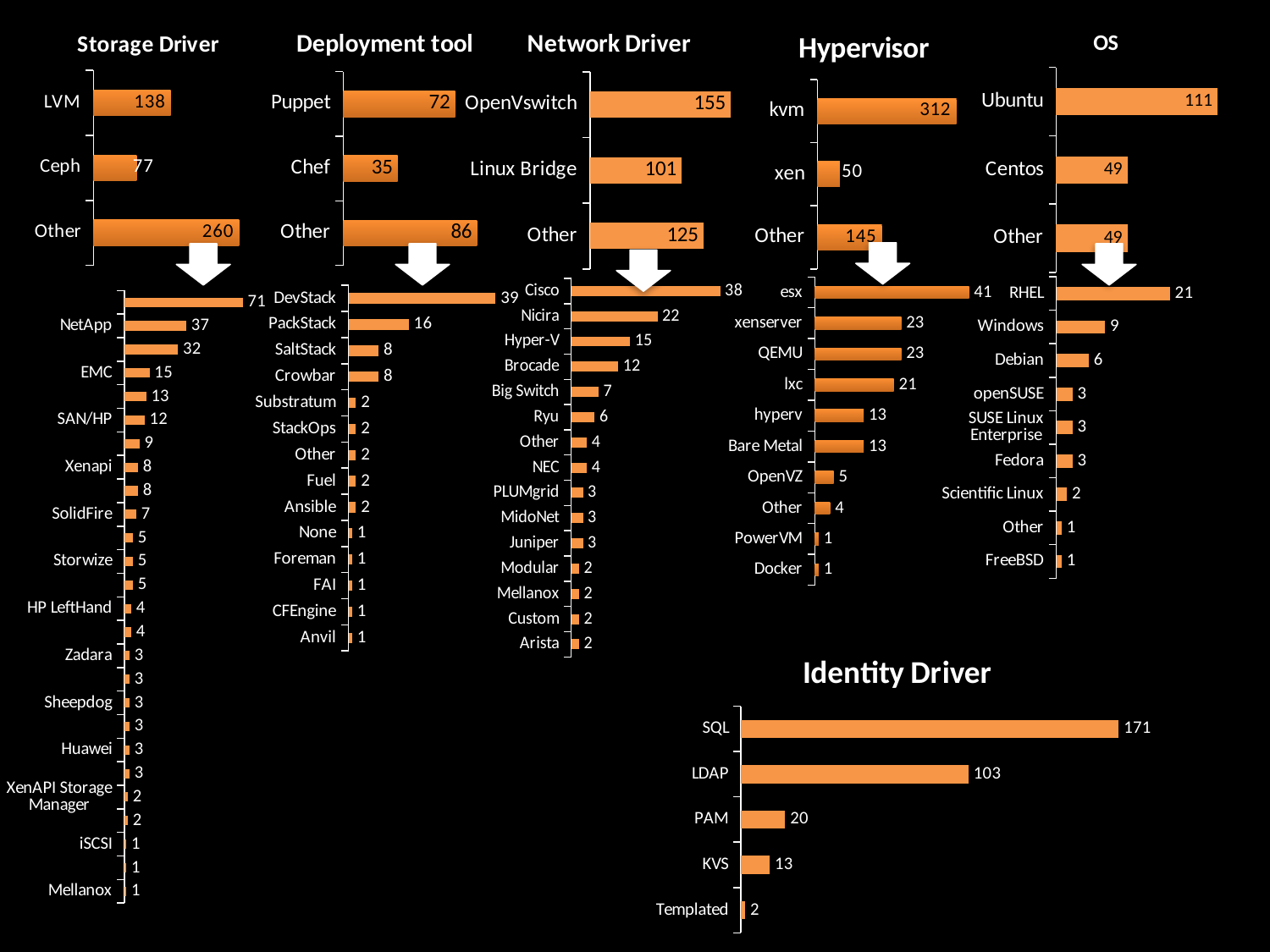
In the Hypervisor breakdown chart below the arrow, what is the value for esx? 41 In the Storage Driver chart at the top, what is the difference between Other and LVM? 122 In the Identity Driver chart, which category has the highest value? SQL In the Network Driver chart at the top, which is larger, Linux Bridge or Other? Other What kind of chart is the Identity Driver chart? Bar chart In the Network Driver breakdown chart below the arrow, what is the value for Nicira? 22 In the Identity Driver chart, what is the difference between SQL and LDAP? 68 How many categories does the Identity Driver chart show? 5 In the Deployment tool chart at the top, what is the value for Chef? 35 In the Identity Driver chart, which category has the lowest value? Templated In the Hypervisor chart, what is the value for kvm? 312 In the OS chart at the top, what is the value for Ubuntu? 111